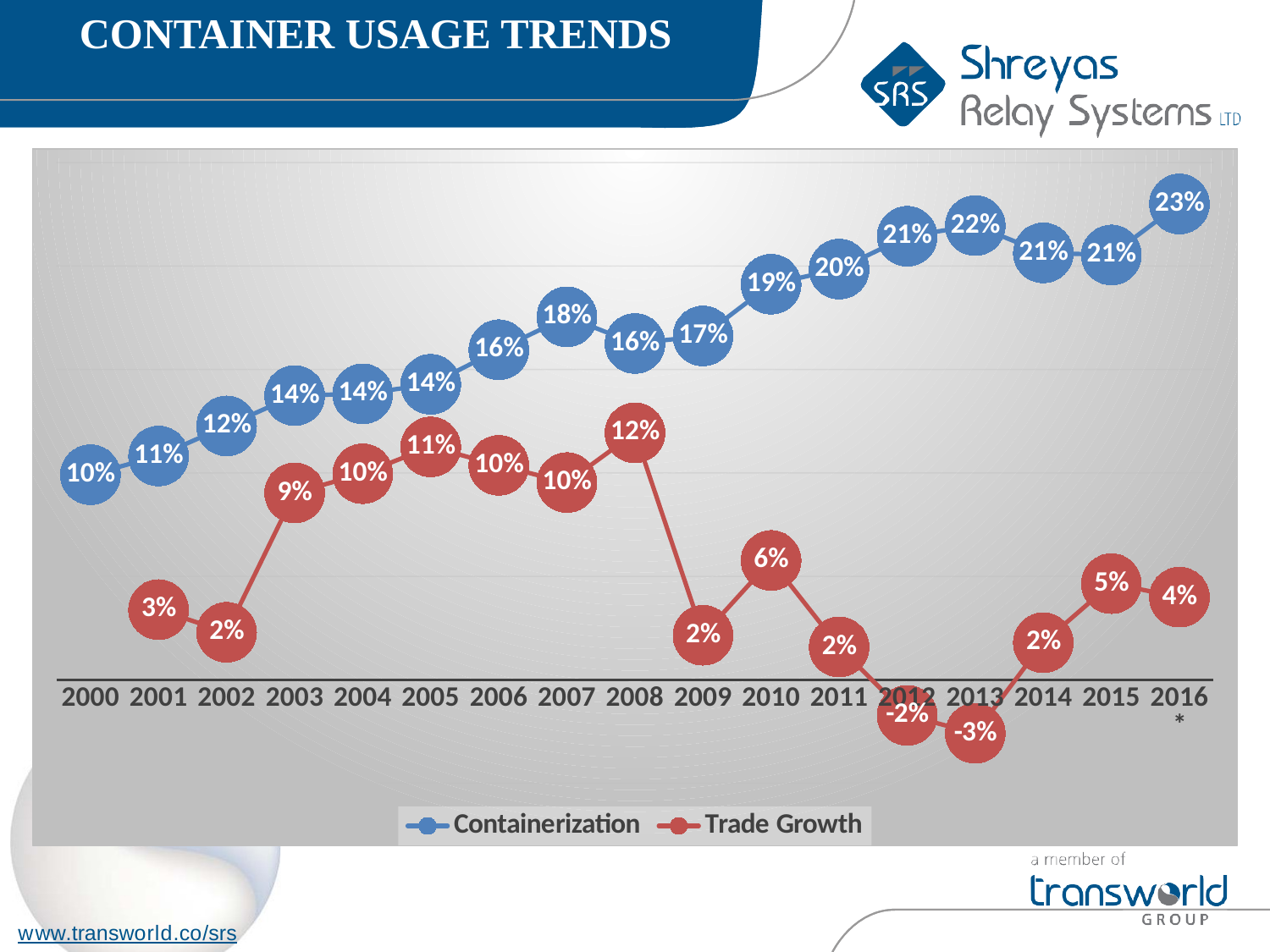
Does the Containerization series generally rise or fall from 2000 to 2016? Rise Which is larger in 2010, Containerization or Trade Growth? Containerization How many years are shown on the x axis? 17 How many series does the legend list? 2 What is the Containerization value for 2000? 10% What is the difference between Containerization and Trade Growth in 2012? 23 percentage points What kind of chart is this? Line chart What is the Trade Growth value for 2013? -3% In which year is Trade Growth at its highest? 2008 In which year is Trade Growth at its lowest? 2013 What is the Trade Growth value for 2008? 12% What is the Containerization value for 2016? 23%